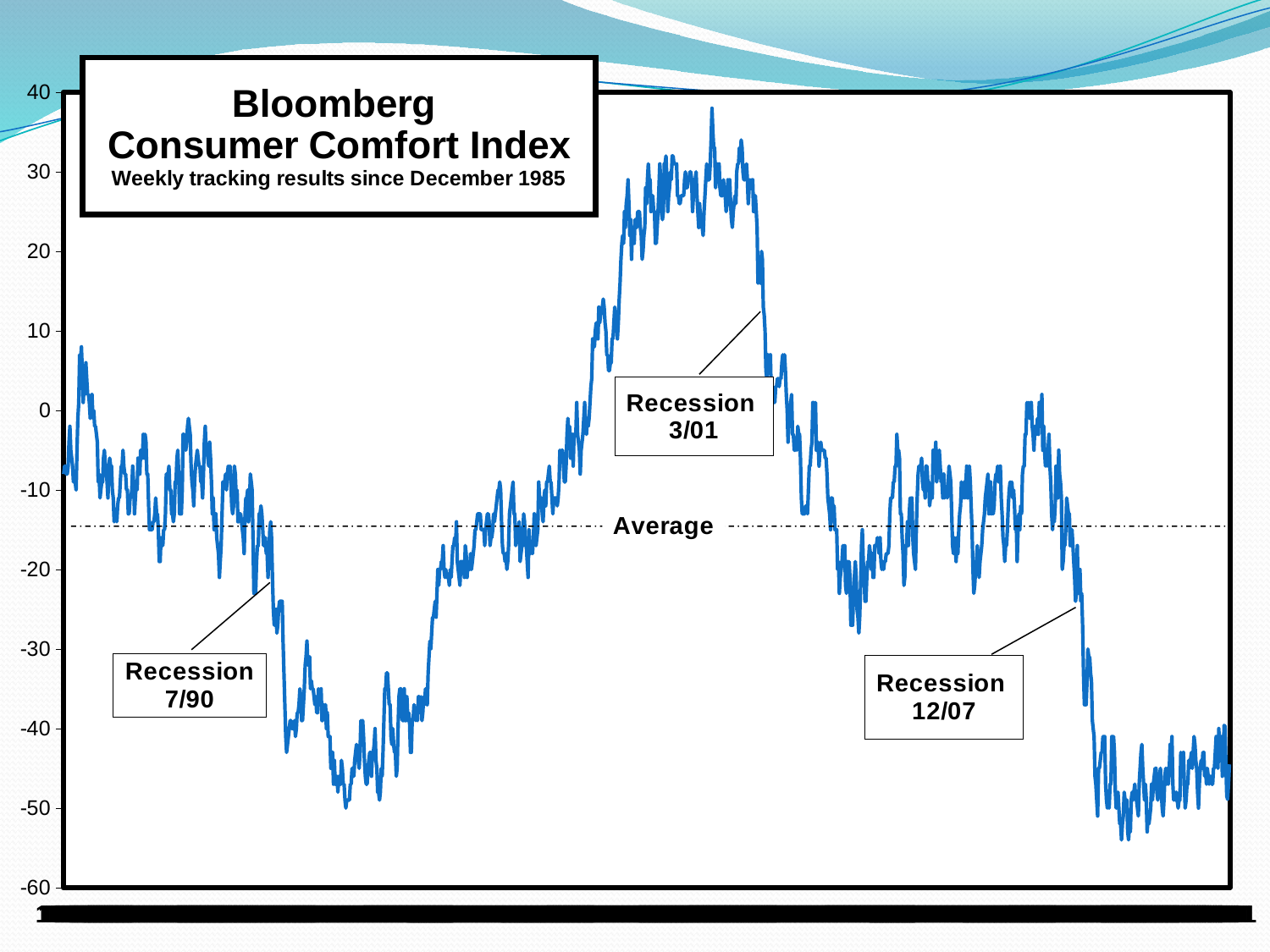
How many recession annotations are marked on the chart? 3 Does the index rise or fall immediately after the point marked Recession 12/07? fall Is the peak value of the index greater or less than 30? greater Is the lowest value of the index greater or less than -50? less Is the Average line greater or less than -10? less Does the index rise or fall immediately after the point marked Recession 3/01? fall What is the title of the chart? Bloomberg Consumer Comfort Index What is the highest value shown on the vertical axis? 40 What is the lowest value shown on the vertical axis? -60 According to the chart's subtitle, since when have the weekly tracking results been collected? December 1985 What kind of chart is shown on the slide? line chart